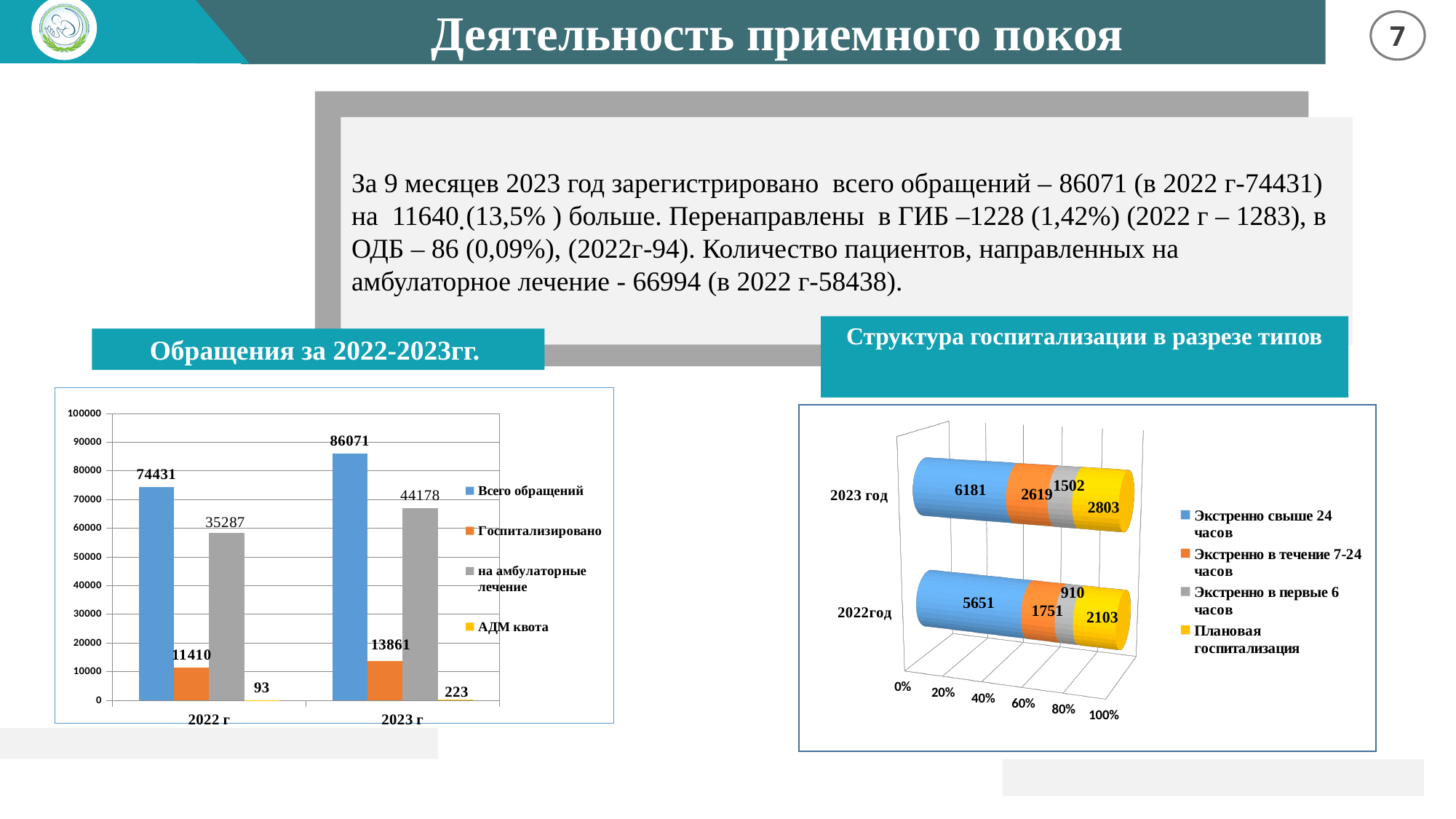
In the chart 'Структура госпитализации в разрезе типов', what is the total of the stacked bar for 2022год? 10415 In the chart 'Обращения за 2022-2023гг.', how many series does the legend list? 4 In the chart 'Обращения за 2022-2023гг.', what is the value of 'АДМ квота' for 2023 г? 223 In the chart 'Структура госпитализации в разрезе типов', what is the value of 'Экстренно в первые 6 часов' for 2022год? 910 In the chart 'Обращения за 2022-2023гг.', what is the difference between 'Всего обращений' in 2023 г and in 2022 г? 11640 In the chart 'Структура госпитализации в разрезе типов', which segment is the largest for 2023 год? Экстренно свыше 24 часов What kind of chart is 'Обращения за 2022-2023гг.'? Bar chart In the chart 'Обращения за 2022-2023гг.', what is the value of 'Всего обращений' for 2023 г? 86071 In the chart 'Обращения за 2022-2023гг.', which series has the lowest value for 2022 г? АДМ квота In the chart 'Структура госпитализации в разрезе типов', is 'Экстренно в течение 7-24 часов' larger in 2023 год or in 2022год? 2023 год In the chart 'Обращения за 2022-2023гг.', what is the value of 'Госпитализировано' for 2022 г? 11410 In the chart 'Структура госпитализации в разрезе типов', what is the value of 'Плановая госпитализация' for 2023 год? 2803